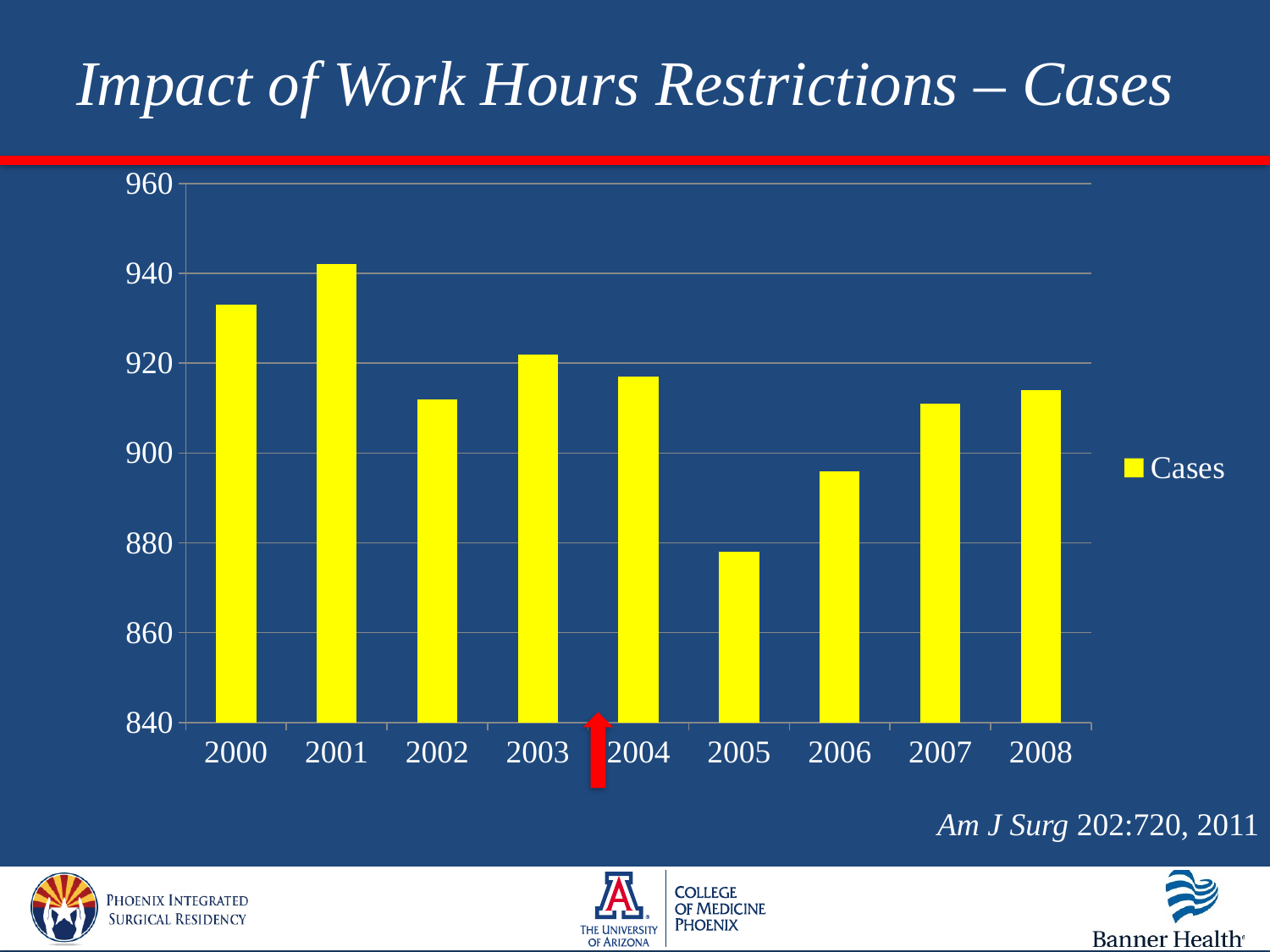
Which year has more cases, 2005 or 2006? 2006 How many years are plotted on the x axis? 9 Which year has the highest number of cases? 2001 What is the name of the series shown in the legend? Cases Is the value for 2000 greater or less than 920? greater Which year has the lowest number of cases? 2005 Which year has more cases, 2000 or 2002? 2000 Is the value for 2008 greater or less than 920? less How many series does the legend list? 1 Is the value for 2006 greater or less than 900? less What kind of chart is shown on the slide? bar chart